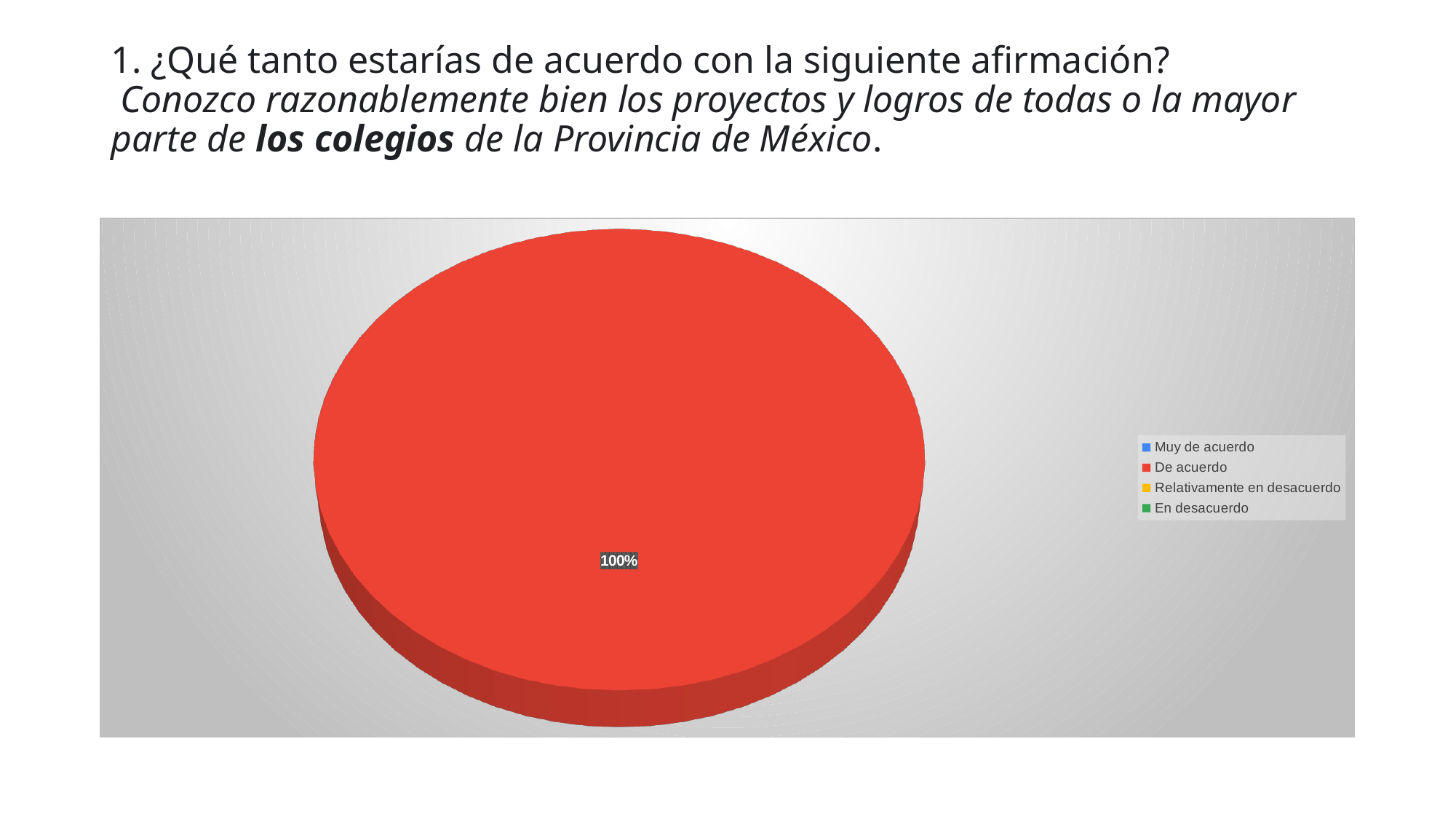
Is the share for "De acuerdo" greater or less than 50%? greater What share of the pie does "De acuerdo" take? 100% What colour is the "De acuerdo" slice? red Which category has the largest share of the pie? De acuerdo What kind of chart is shown on the slide? pie chart Which is larger, the share for "De acuerdo" or the share for "Muy de acuerdo"? De acuerdo How many entries does the legend list? 4 Which legend entry is shown in green? En desacuerdo How many slices are visible in the pie? 1